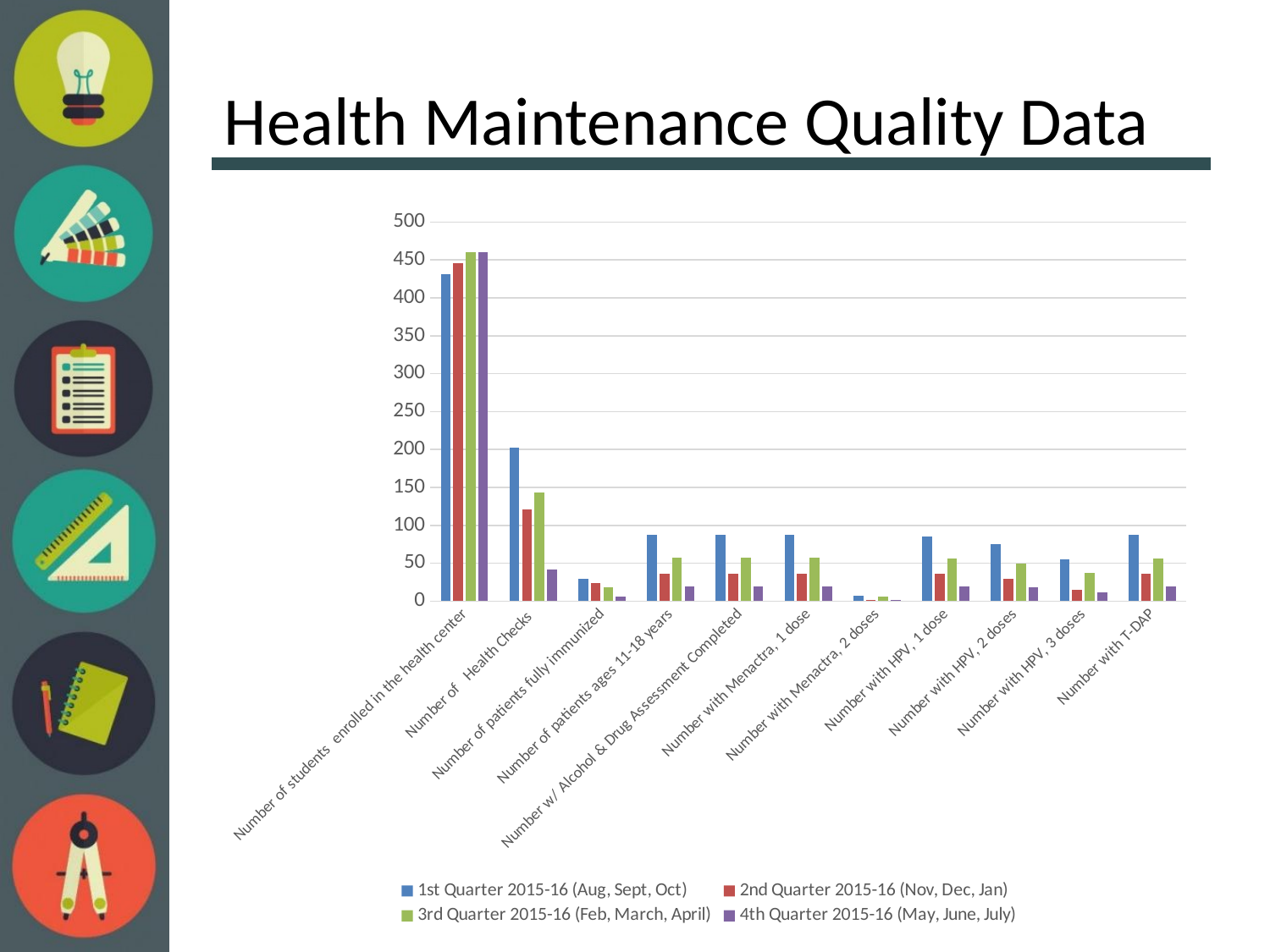
Which category has the highest 1st Quarter 2015-16 value? Number of students enrolled in the health center What is the title of the slide containing the chart? Health Maintenance Quality Data Is the 1st Quarter 2015-16 value for Number of students enrolled in the health center greater or less than 400? greater Is the 3rd Quarter 2015-16 value for Number with T-DAP greater or less than 100? less Which category has the lowest 1st Quarter 2015-16 value? Number with Menactra, 2 doses How many series does the legend list? 4 Is the 4th Quarter 2015-16 value for Number of Health Checks greater or less than 50? less What kind of chart is shown on the slide? bar chart For Number with HPV, 1 dose, which is larger: the 3rd Quarter 2015-16 value or the 4th Quarter 2015-16 value? 3rd Quarter 2015-16 For Number of Health Checks, which is larger: the 1st Quarter 2015-16 value or the 2nd Quarter 2015-16 value? 1st Quarter 2015-16 How many categories are shown along the x axis? 11